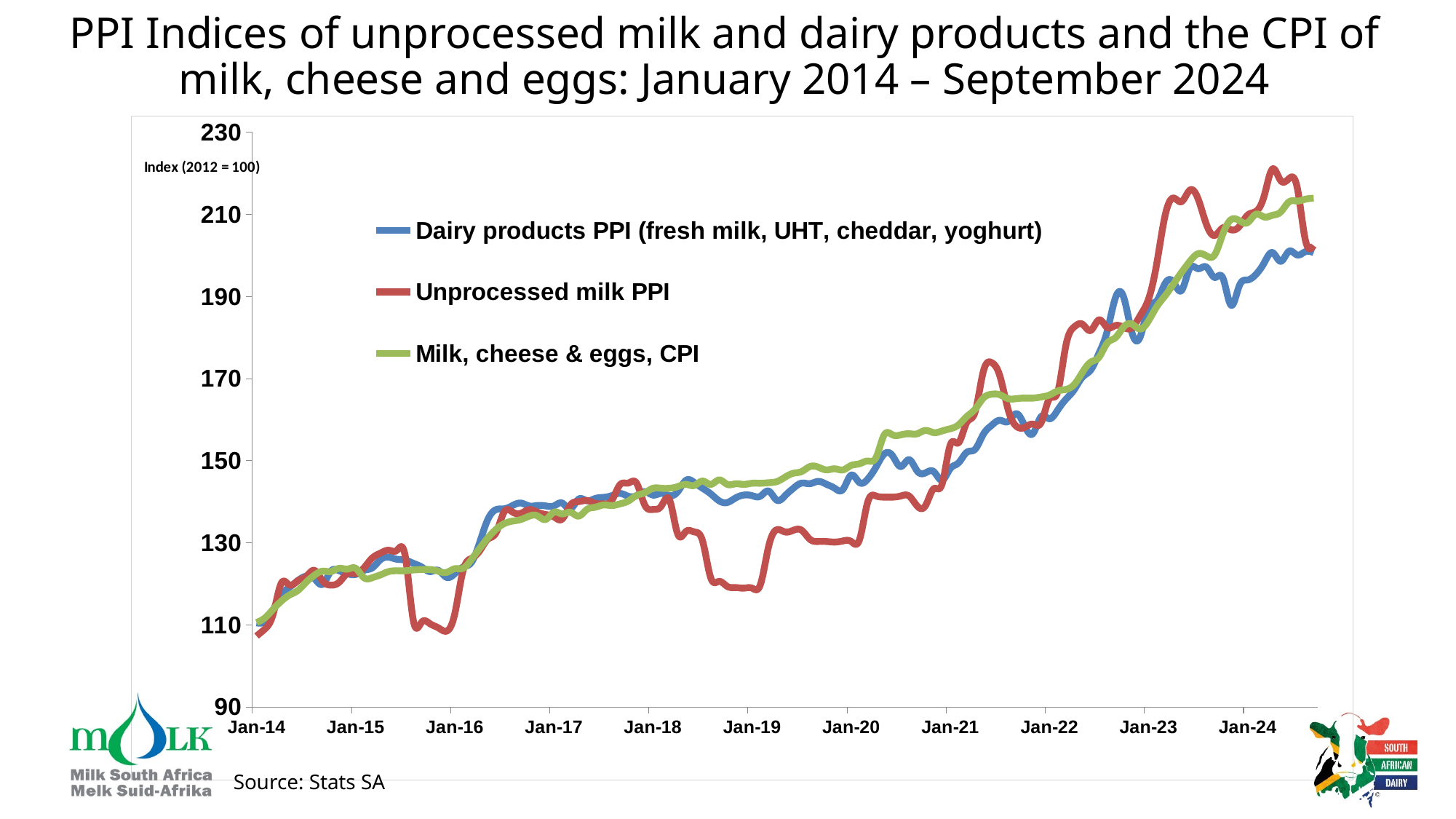
Is the Unprocessed milk PPI at Jan-19 greater or less than 130? less Is the Milk, cheese & eggs CPI at Jan-24 greater or less than 190? greater How many series does the legend list? 3 What base year note is printed on the chart for the index? Index (2012 = 100) At Jan-19, which is higher: the Unprocessed milk PPI or the Milk, cheese & eggs CPI? Milk, cheese & eggs, CPI Is the Dairy products PPI at Jan-16 greater or less than 130? less What type of chart is shown on the slide? Line chart How many year labels are shown on the x axis? 11 Which series reaches the highest value anywhere on the chart? Unprocessed milk PPI At Jan-24, which is higher: the Unprocessed milk PPI or the Dairy products PPI? Unprocessed milk PPI What are the three series named in the legend? Dairy products PPI (fresh milk, UHT, cheddar, yoghurt); Unprocessed milk PPI; Milk, cheese & eggs, CPI Overall, do the index values rise or fall from Jan-14 to the end of the series in 2024? Rise